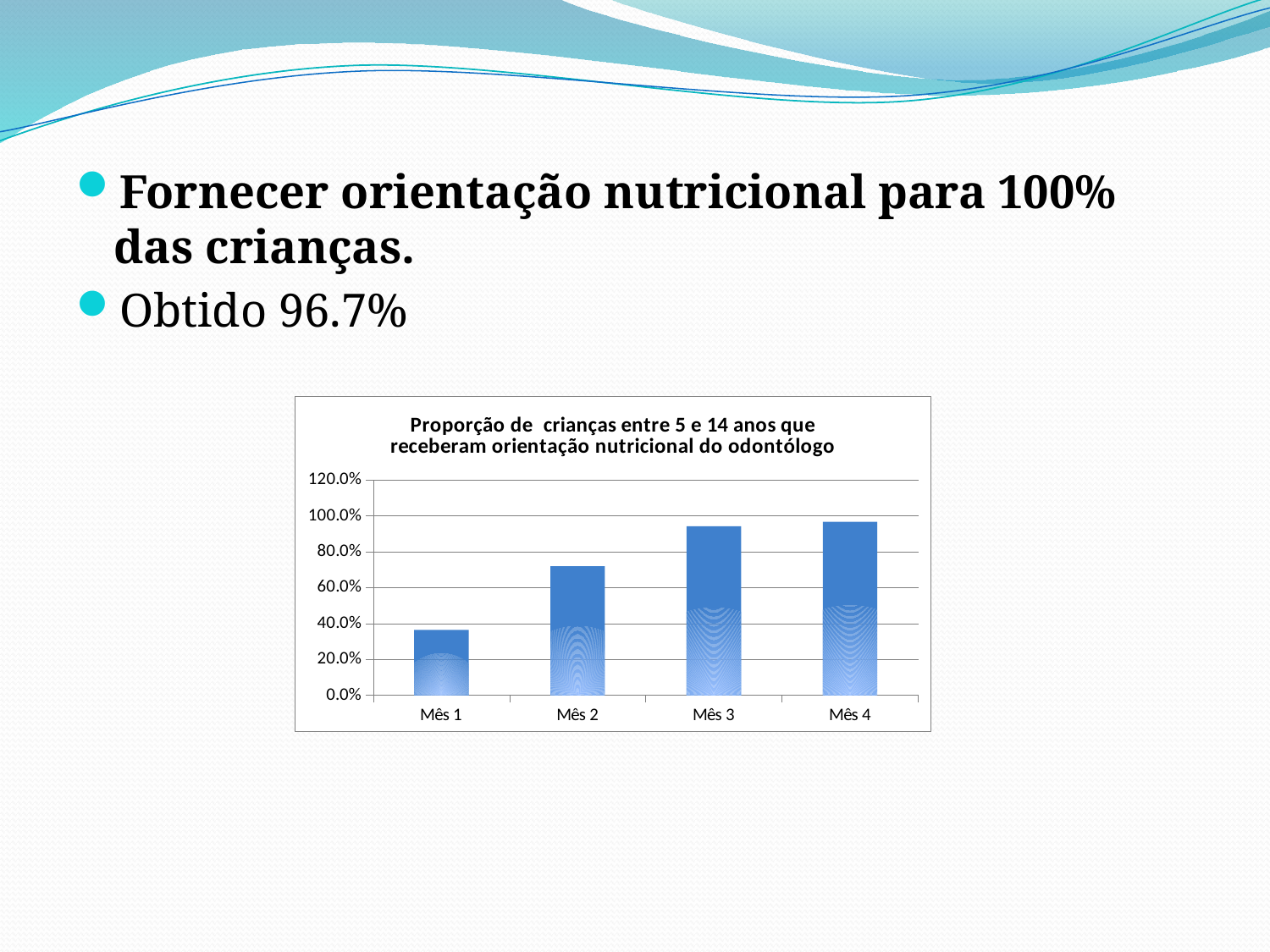
Which month has the lowest proportion of children who received nutritional guidance? Mês 1 What kind of chart is shown on the slide? Bar chart Is the value for Mês 3 greater or less than 80.0%? greater Is the value for Mês 1 greater or less than 40.0%? less Do the values rise or fall from Mês 1 to Mês 4? Rise Is the value for Mês 1 greater or less than 20.0%? greater What is the title of the chart? Proporção de crianças entre 5 e 14 anos que receberam orientação nutricional do odontólogo Which is larger, the value for Mês 1 or the value for Mês 2? Mês 2 How many months (categories) are plotted on the chart? 4